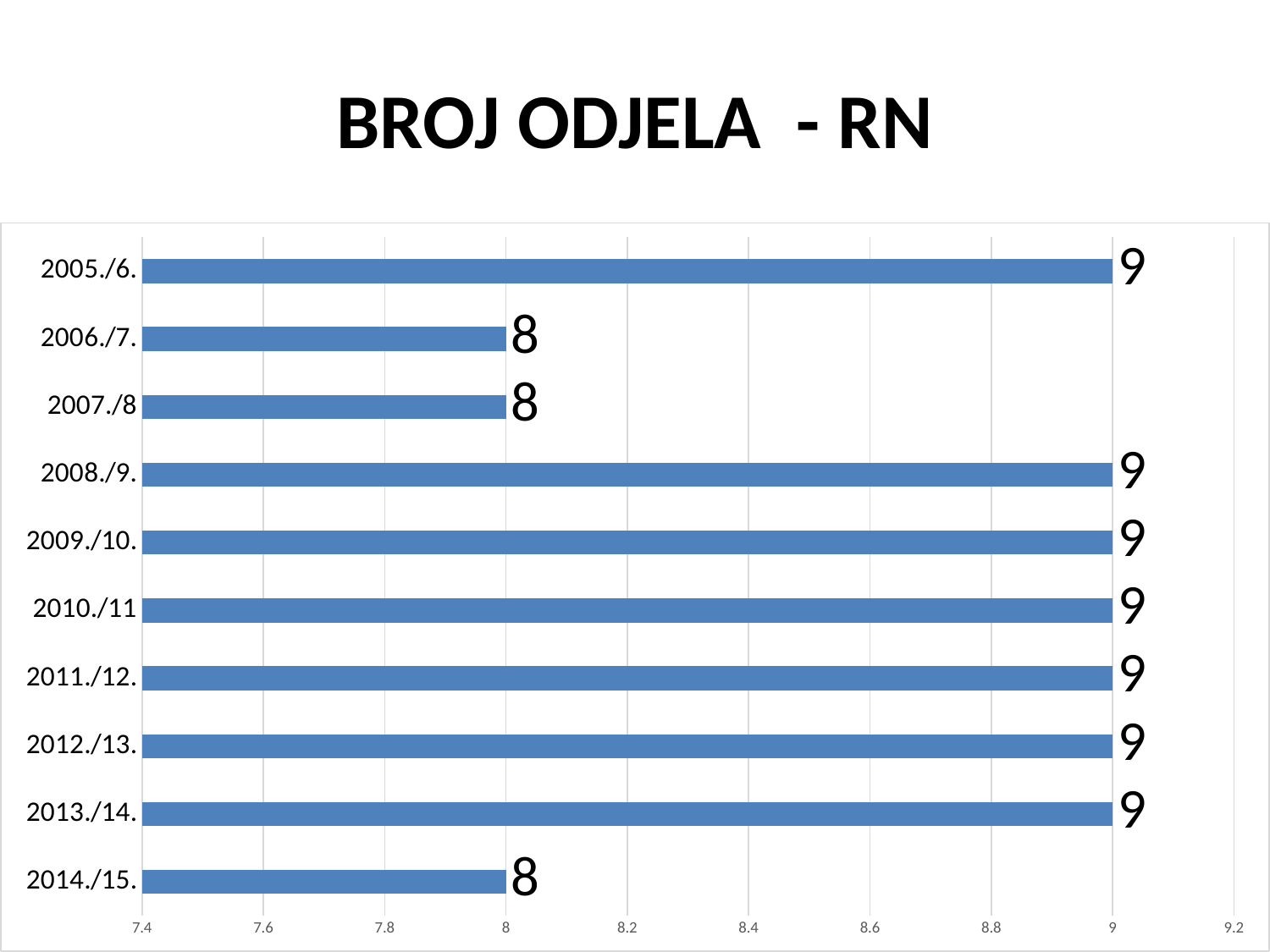
What is the value for 2005./6.? 9 Is the value for 2014./15. greater or less than 8.6? less What is the value for 2006./7.? 8 What is the value for 2011./12.? 9 What is the title of the chart? BROJ ODJELA - RN Which category has the lowest value: 2007./8 or 2008./9.? 2007./8 Is the value for 2013./14. greater or less than 8.4? greater How many categories are shown in the chart? 10 What kind of chart is shown on the slide? bar chart What is the value for 2014./15.? 8 What is the difference between the values for 2005./6. and 2006./7.? 1 How many categories have a value of 8? 3